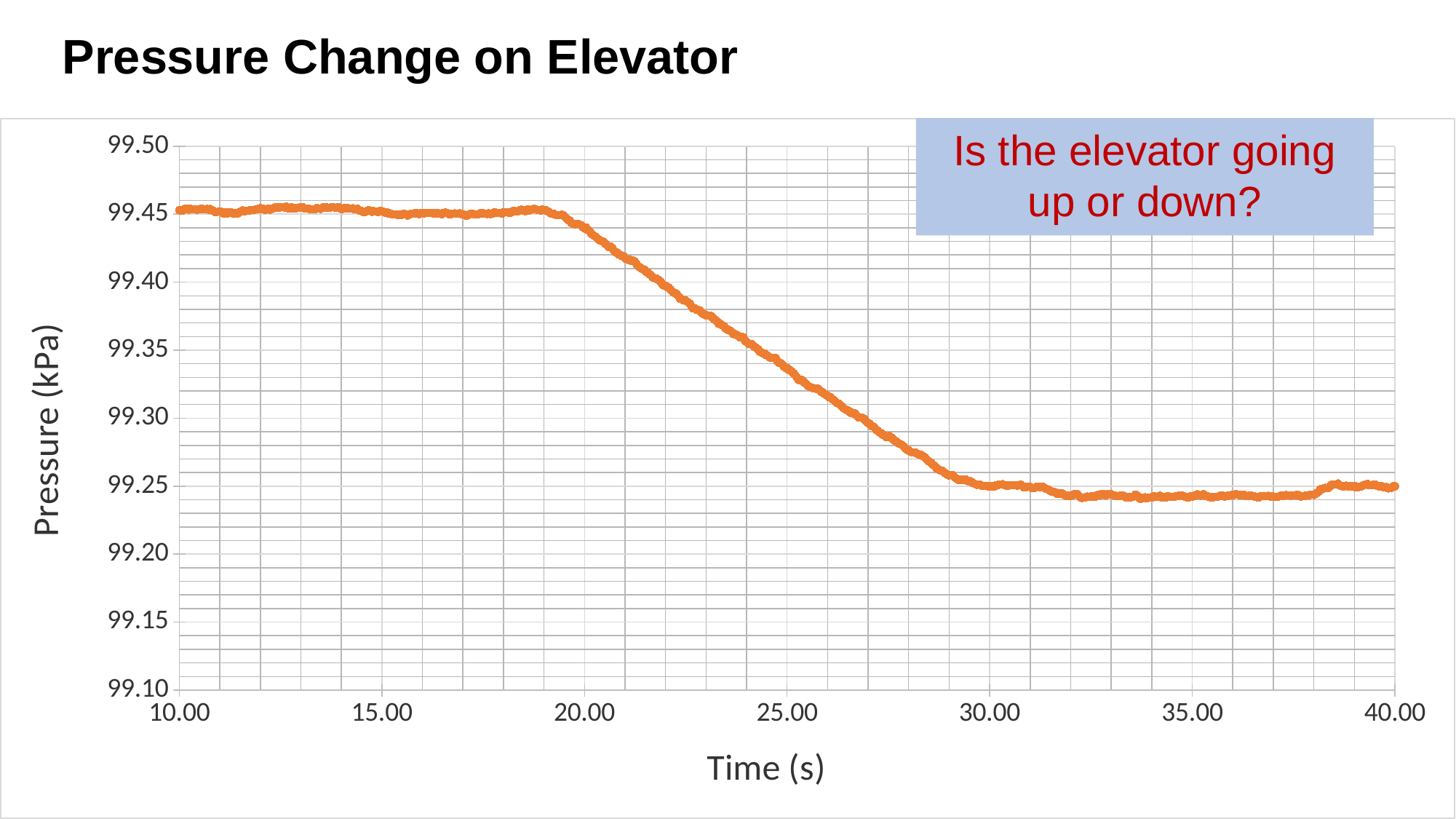
What is the title of the chart? Pressure Change on Elevator Overall, does the pressure rise or fall from 10.00 s to 40.00 s? fall Is the pressure at 25.00 s greater or less than 99.40? less What kind of chart is shown on the slide? line chart Does the pressure rise or fall between 20.00 s and 30.00 s? fall Is the pressure higher at 15.00 s or at 35.00 s? 15.00 s Is the pressure at 15.00 s greater or less than 99.40? greater What is the label of the vertical axis? Pressure (kPa) Is the pressure at 35.00 s greater or less than 99.30? less Is the pressure higher at 22.00 s or at 28.00 s? 22.00 s